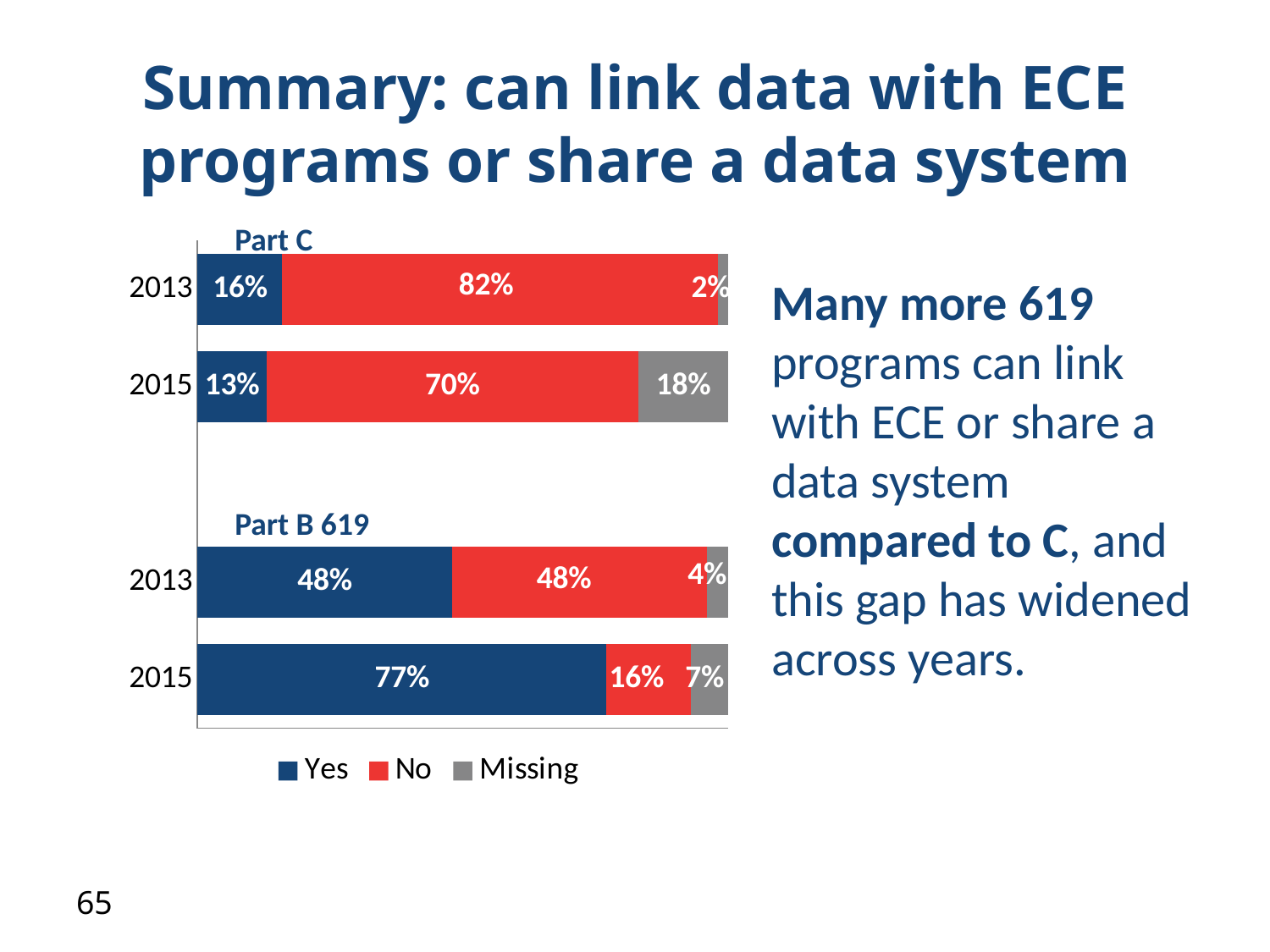
Does the Yes percentage for Part B 619 rise or fall from 2013 to 2015? Rise How many series does the legend list? 3 Which bar has the lowest Yes percentage? Part C, 2015 Which bar has the highest Yes percentage? Part B 619, 2015 What percentage of Part C programs answered Yes in 2013? 16% What colour represents the Missing series in the chart? Grey What percentage of Part B 619 programs answered No in 2013? 48% What is the Missing share for Part C in 2015? 18% Which is larger: the No percentage for Part C in 2013 or for Part C in 2015? Part C in 2013 What kind of chart is shown on the slide? Stacked bar chart What is the difference between the Yes percentage for Part B 619 in 2015 and in 2013? 29% What percentage of Part B 619 programs answered Yes in 2015? 77%